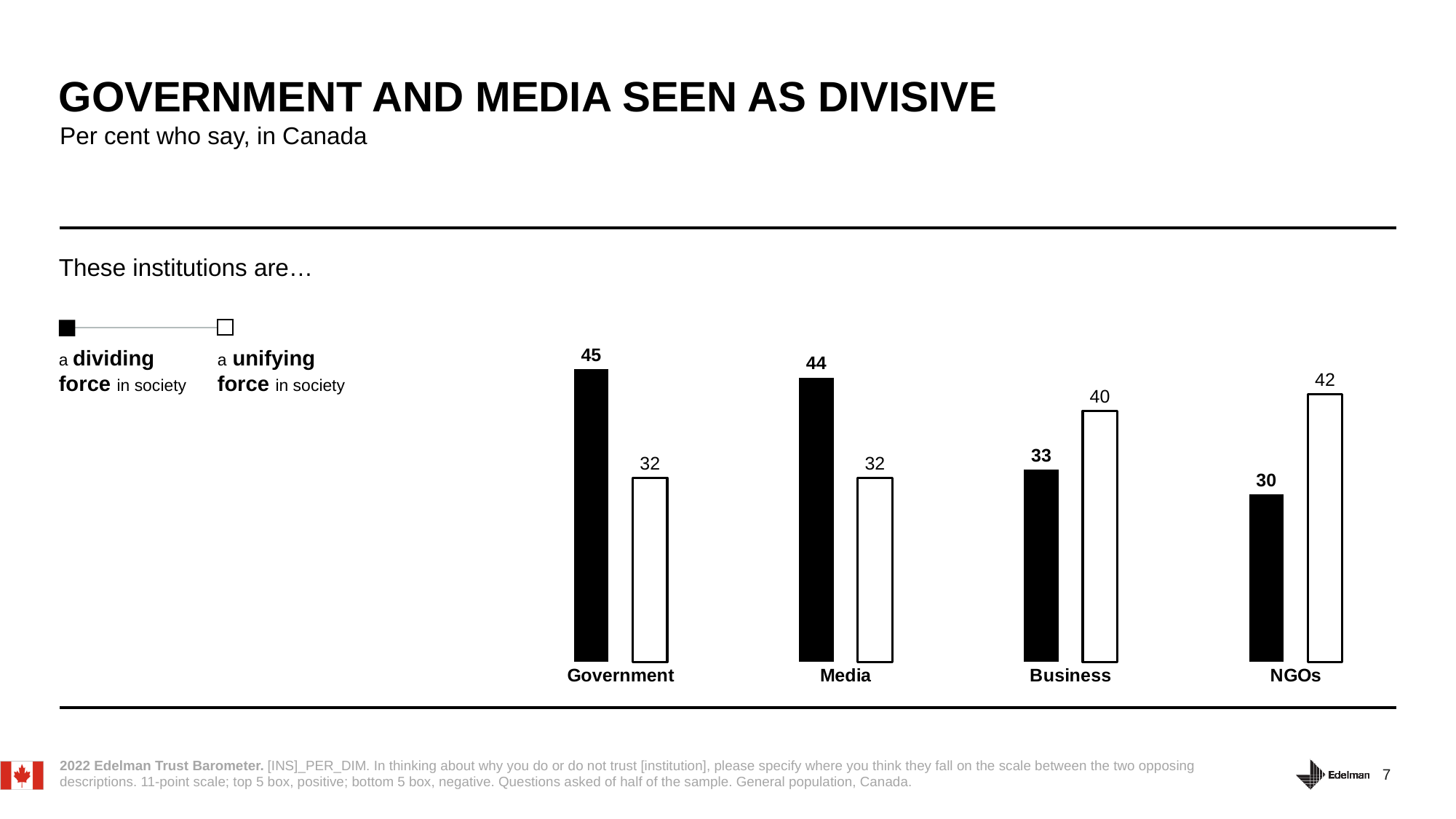
Which institution has the highest per cent saying it is a dividing force in society? Government How many institutions are shown on the chart? 4 What per cent say NGOs are a unifying force in society? 42 What per cent say Government is a dividing force in society? 45 What per cent say Business is a dividing force in society? 33 For Business, which is larger: the per cent saying it is a dividing force or a unifying force? a unifying force Which institution has the highest per cent saying it is a unifying force in society? NGOs What kind of chart is shown on the slide? bar chart What is the difference between the dividing force and unifying force values for Government? 13 Which institution has the lowest per cent saying it is a dividing force in society? NGOs What is the difference between the unifying force values for NGOs and Media? 10 How many series does the legend list? 2